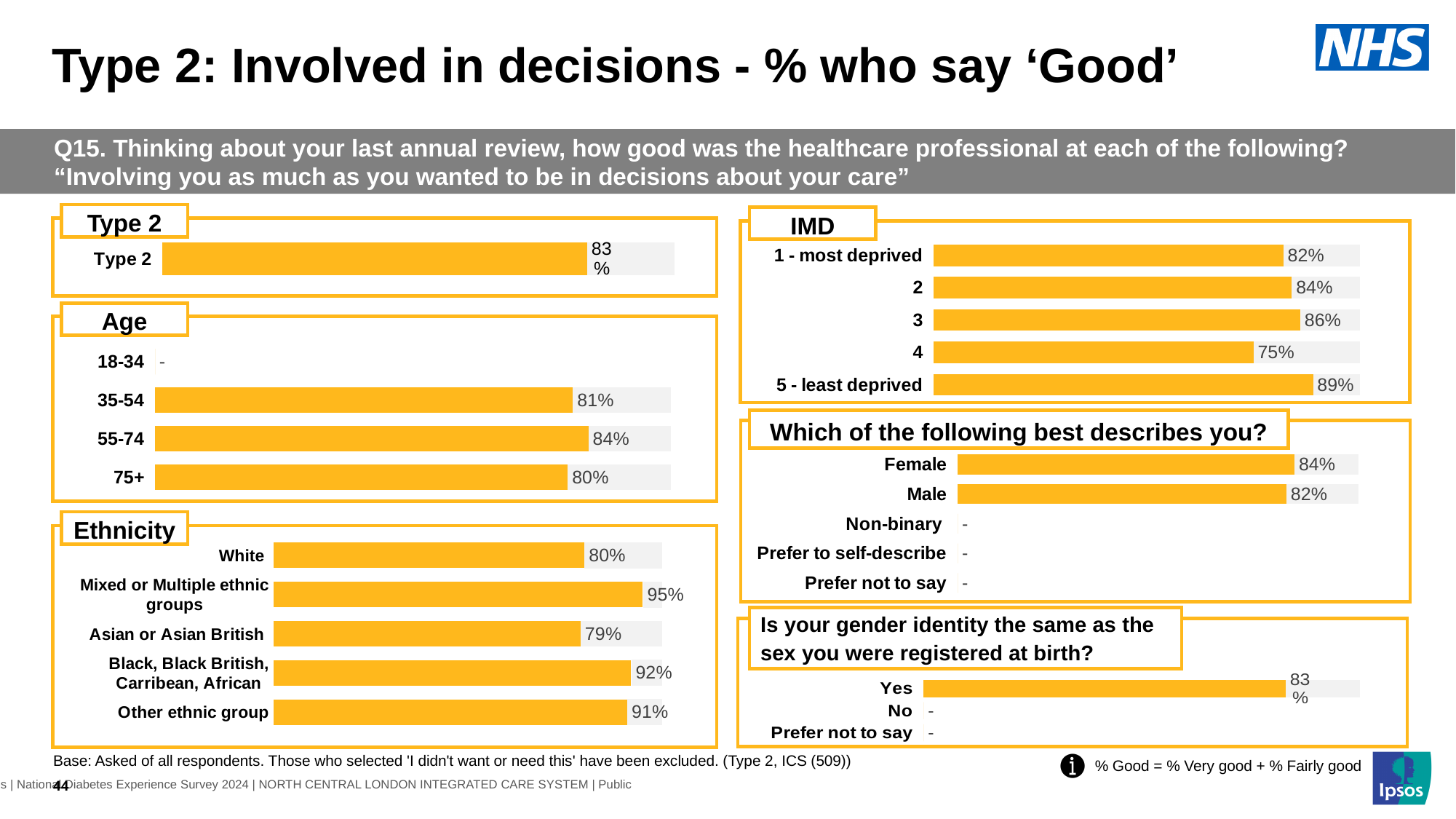
In the IMD chart, which group has the lowest value? 4 In the IMD chart, which group has the highest value? 5 - least deprived In the Type 2 chart, what is the value for Type 2? 83% What type of chart is used on this slide? Bar chart In the 'Is your gender identity the same as the sex you were registered at birth?' chart, what is the value for Yes? 83% In the 'Which of the following best describes you?' chart, which is larger, Female or Male? Female In the Age chart, what is the value for 55-74? 84% In the Ethnicity chart, which ethnic group has the highest value? Mixed or Multiple ethnic groups In the IMD chart, what is the value for 3? 86% In the Ethnicity chart, what is the value for Asian or Asian British? 79% In the Age chart, which age group has the lowest value among those with a bar shown? 75+ In the Ethnicity chart, what is the difference between Black, Black British, Carribean, African and White? 12 percentage points